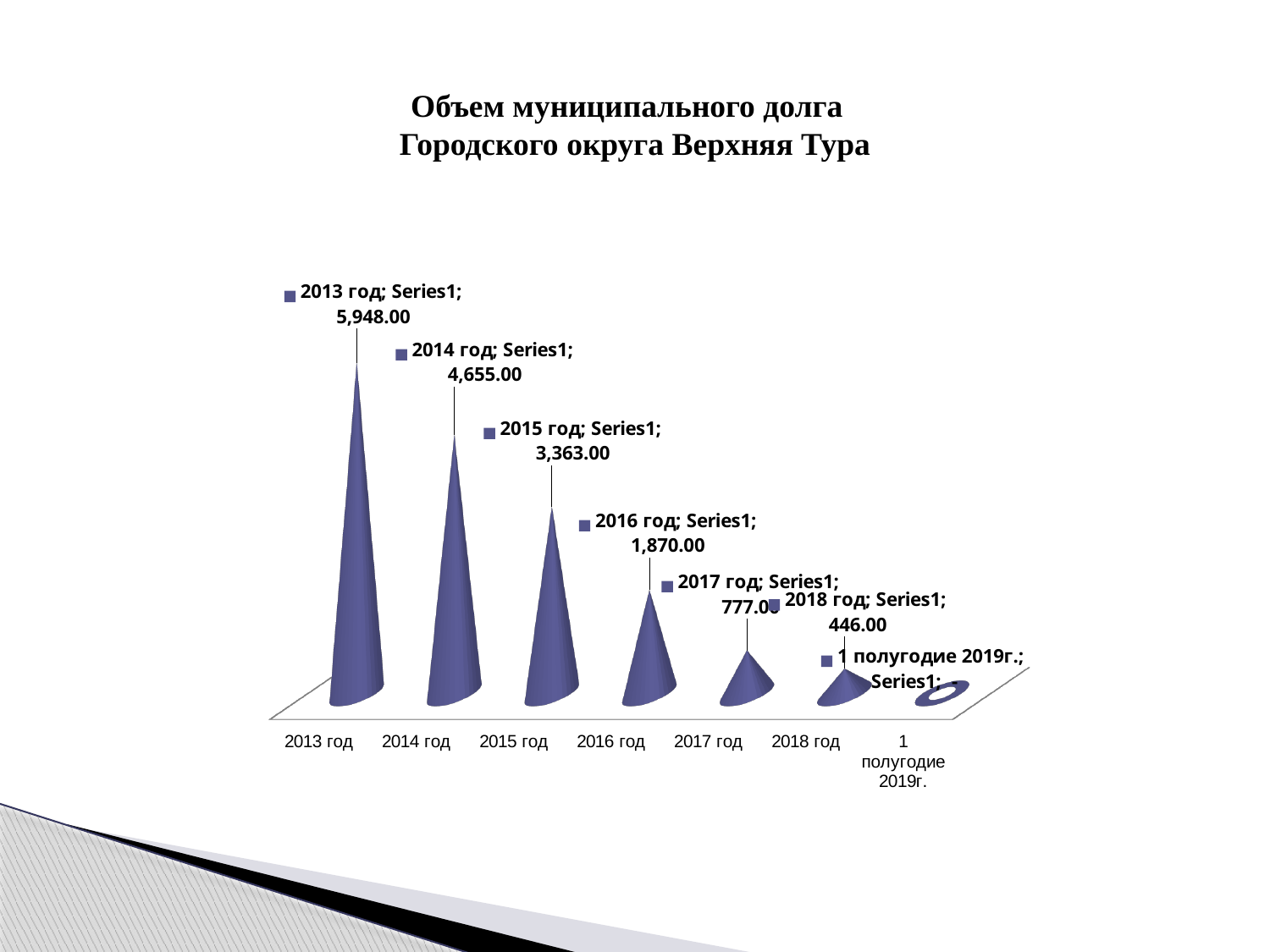
Which is larger, the value for 2016 год or the value for 2015 год? 2015 год What is the value for 2017 год? 777.00 What is the difference between the values for 2017 год and 2018 год? 331.00 Do the values rise or fall from 2013 год to 1 полугодие 2019г.? fall Which category has the highest value? 2013 год What is the difference between the values for 2013 год and 2014 год? 1,293.00 Which category has the lowest value? 1 полугодие 2019г. What is the value for 2015 год? 3,363.00 How many categories are shown on the x axis? 7 What is the value for 2018 год? 446.00 What is the value for 2013 год? 5,948.00 What kind of chart is shown on the slide? bar chart